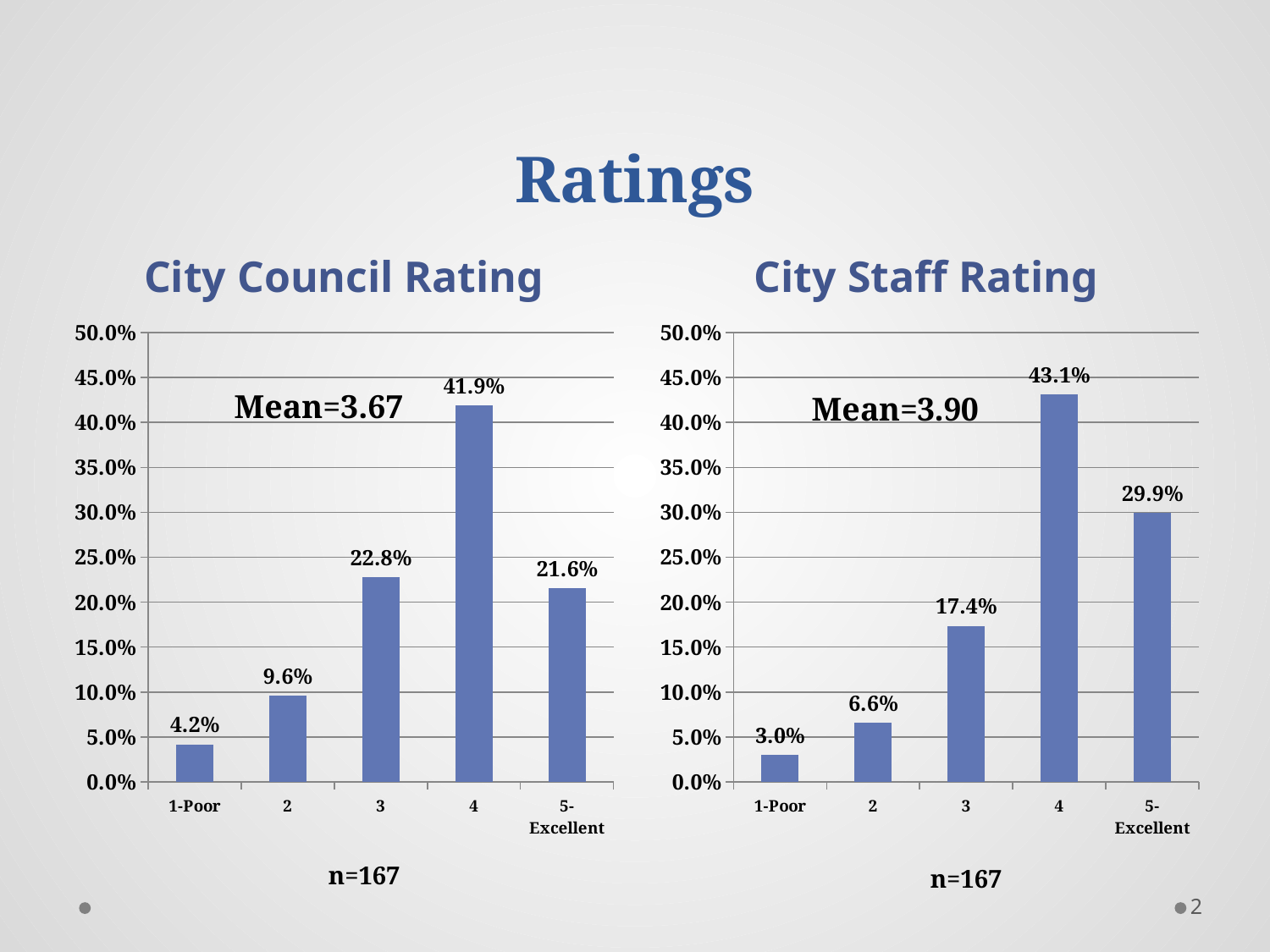
In the City Council Rating chart, what percentage of respondents gave a rating of 4? 41.9% In the City Council Rating chart, what is the difference between the percentages for rating 3 and rating 2? 13.2% Which is larger: the percentage for rating 3 in the City Council Rating chart or the percentage for rating 3 in the City Staff Rating chart? City Council Rating What mean value is shown on the City Council Rating chart? Mean=3.67 How many rating categories are shown on the x axis of the City Council Rating chart? 5 In the City Staff Rating chart, what percentage of respondents gave a rating of 5-Excellent? 29.9% In the City Staff Rating chart, what is the difference between the percentages for rating 4 and rating 5-Excellent? 13.2% In the City Staff Rating chart, is the value for rating 4 greater or less than 40.0%? greater In the City Staff Rating chart, which rating category has the highest percentage? 4 In the City Council Rating chart, which rating category has the lowest percentage? 1-Poor What sample size (n) is shown below the City Staff Rating chart? n=167 What kind of chart is the City Staff Rating chart? Bar chart